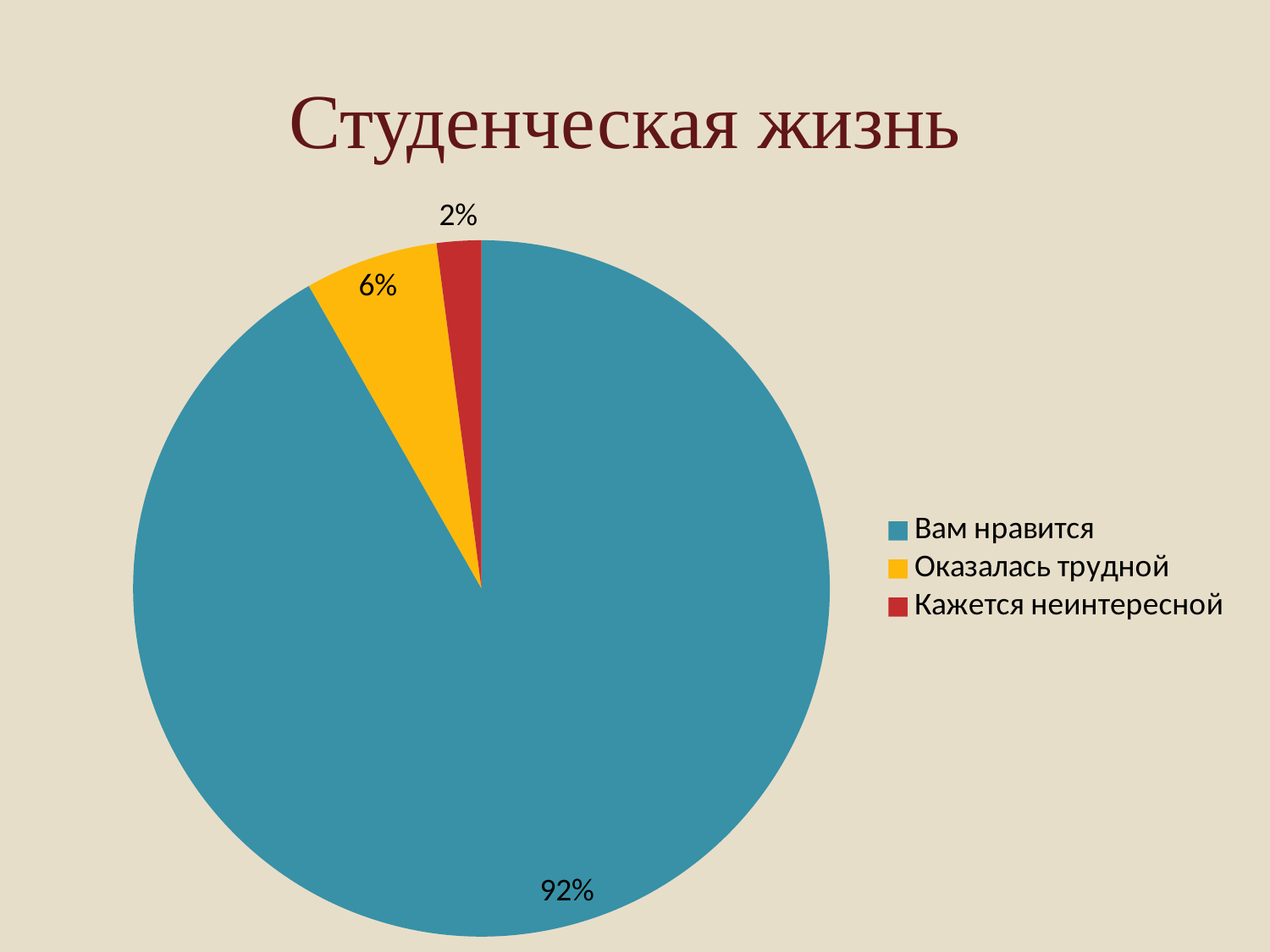
Which is larger: the slice for "Оказалась трудной" or the slice for "Кажется неинтересной"? Оказалась трудной What percentage is shown for "Вам нравится"? 92% How many categories does the pie chart have? 3 What is the title of the chart? Студенческая жизнь Which category has the largest slice of the pie? Вам нравится What is the difference in percentage points between "Оказалась трудной" and "Кажется неинтересной"? 4 What colour is the slice for "Оказалась трудной"? yellow What percentage is shown for "Кажется неинтересной"? 2% What type of chart is shown on the slide? pie chart What percentage is shown for "Оказалась трудной"? 6% What is the difference in percentage points between "Вам нравится" and "Оказалась трудной"? 86 Which category has the smallest slice of the pie? Кажется неинтересной